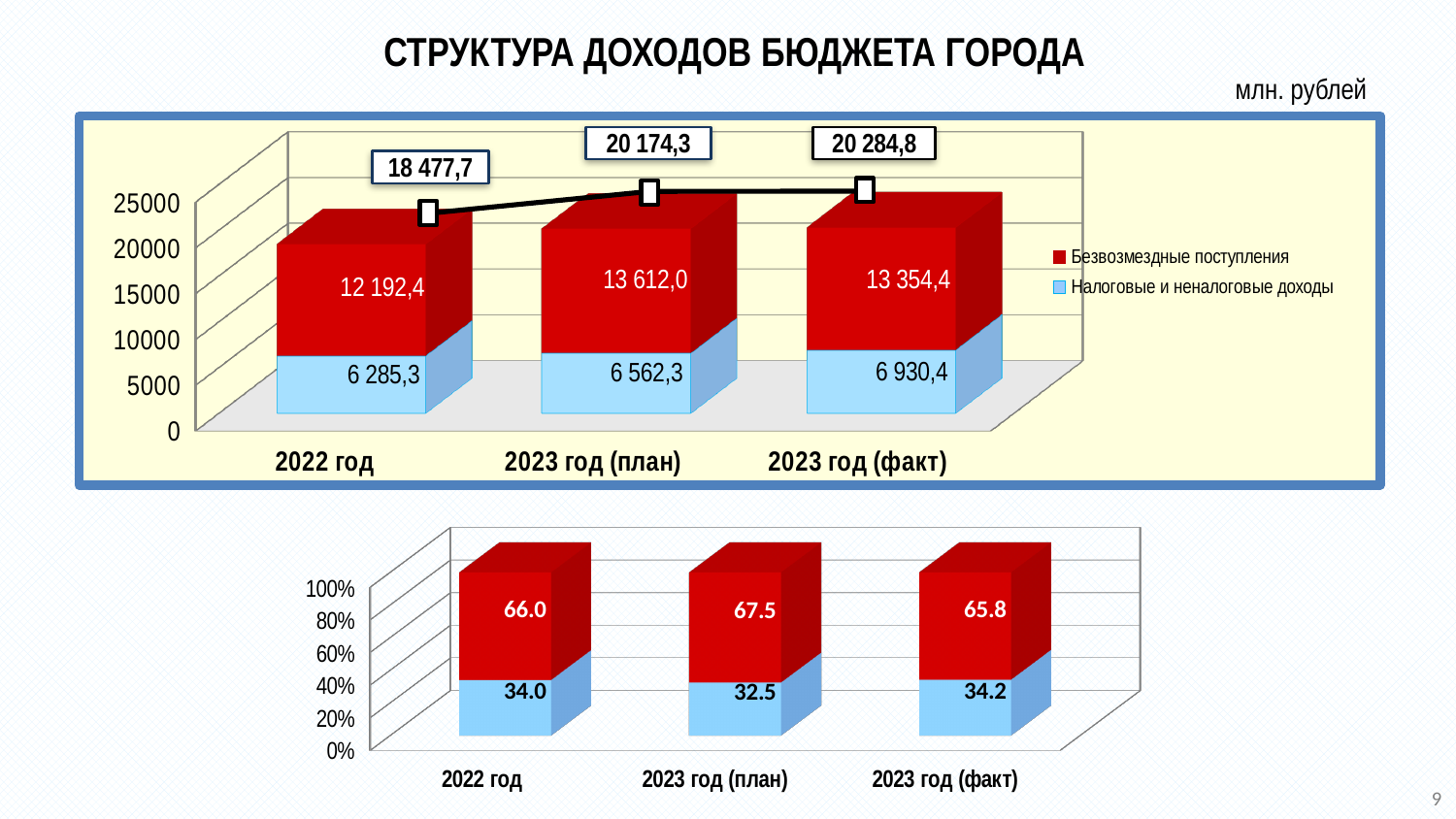
What kind of chart is the bottom chart? bar chart In the top chart, what is the value of Налоговые и неналоговые доходы for 2022 год? 6 285,3 In the top chart, what total is shown above the bar for 2023 год (факт)? 20 284,8 How many series does the legend of the top chart list? 2 In the top chart, what is the difference between Безвозмездные поступления for 2023 год (план) and 2023 год (факт)? 257,6 How many categories are shown on the x axis of the top chart? 3 In the bottom chart, what is the value of the blue segment (Налоговые и неналоговые доходы) for 2023 год (план)? 32.5 What unit is indicated above the top chart? млн. рублей In the top chart, which category has the highest value for Налоговые и неналоговые доходы? 2023 год (факт) In the top chart, what is the value of Безвозмездные поступления for 2023 год (план)? 13 612,0 In the bottom chart, which category has the lowest value for the red segment (Безвозмездные поступления)? 2023 год (факт) In the top chart, which is larger: Безвозмездные поступления for 2022 год or for 2023 год (факт)? 2023 год (факт)